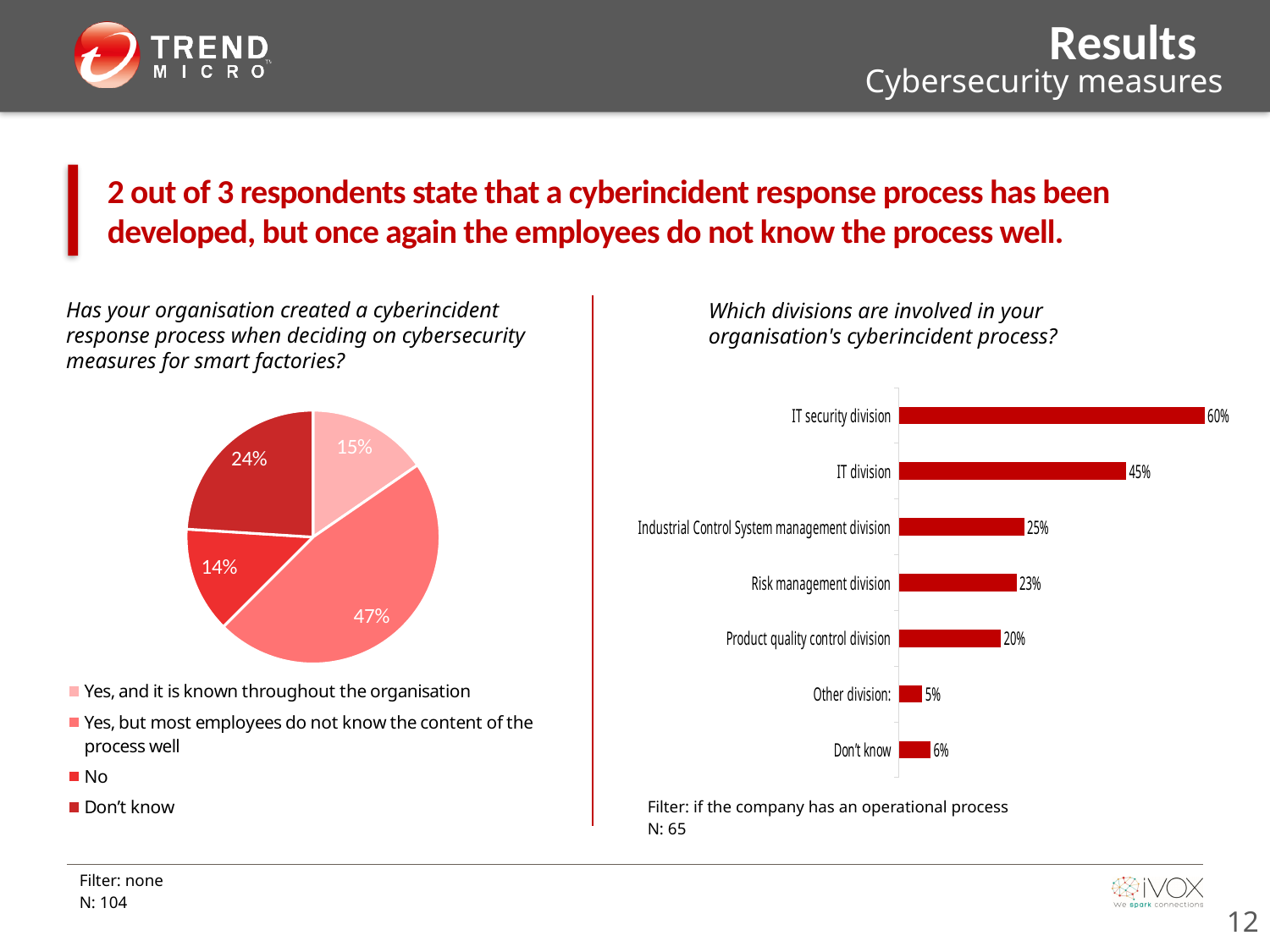
In the chart titled "Which divisions are involved in your organisation's cyberincident process?", what is the difference between IT security division and IT division? 15% In the chart titled "Which divisions are involved in your organisation's cyberincident process?", which division has the lowest value? Other division In the chart titled "Which divisions are involved in your organisation's cyberincident process?", what is the value for IT security division? 60% What kind of chart is the one on the right of the slide? Bar chart In the pie chart on the left, which answer has the largest share? Yes, but most employees do not know the content of the process well In the pie chart on the left, what share of respondents answered "Yes, but most employees do not know the content of the process well"? 47% In the chart titled "Which divisions are involved in your organisation's cyberincident process?", which is larger: Industrial Control System management division or Product quality control division? Industrial Control System management division In the chart titled "Which divisions are involved in your organisation's cyberincident process?", how many categories are shown? 7 In the chart titled "Which divisions are involved in your organisation's cyberincident process?", what is the value for Risk management division? 23% In the pie chart on the left, what is the difference between the "Don't know" share and the "No" share? 10% In the pie chart on the left, what share of respondents answered "No"? 14% In the pie chart on the left, how many answer options does the legend list? 4